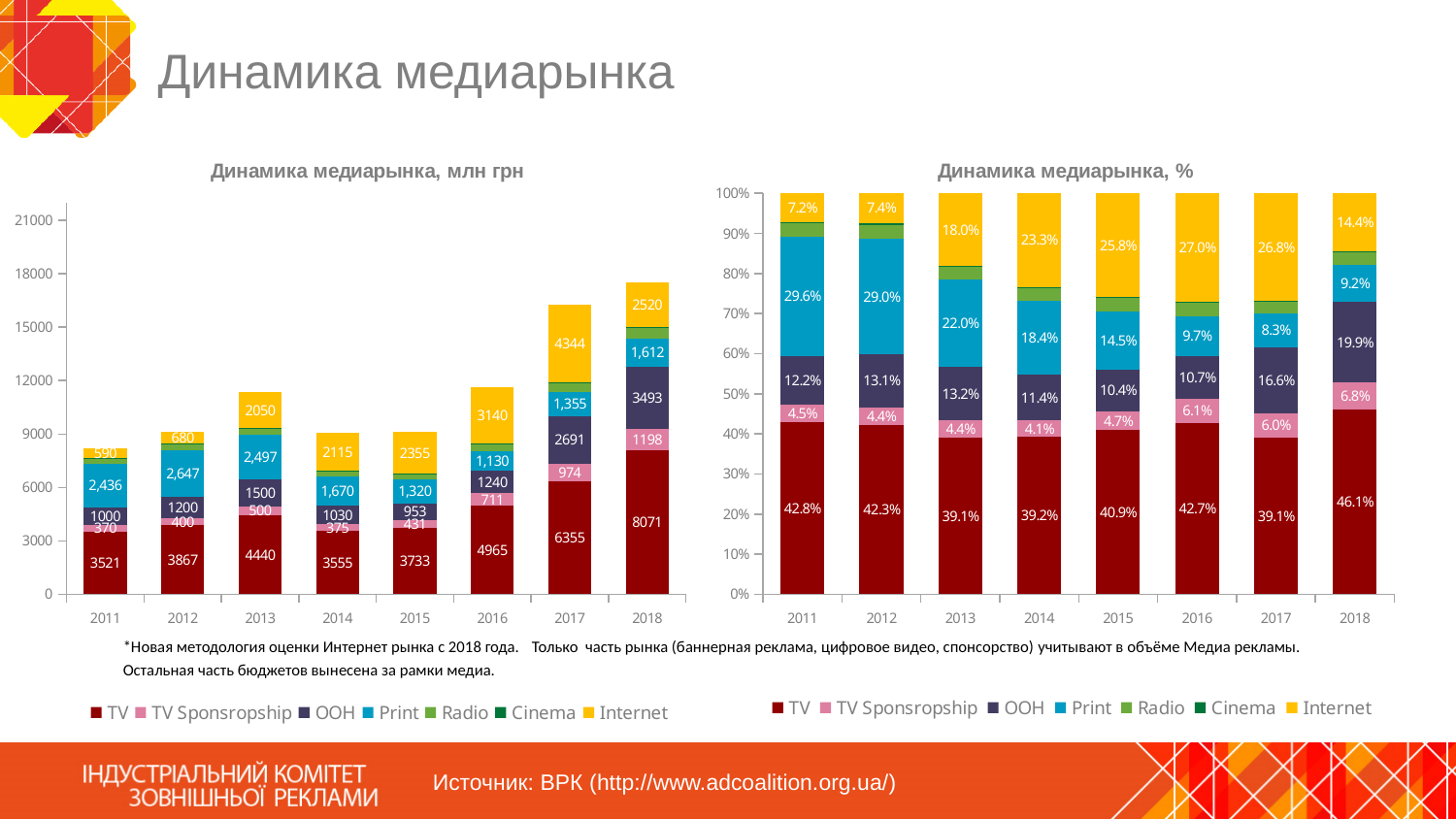
In the chart 'Динамика медиарынка, %', which is larger in 2018: the OOH share or the Print share? OOH In the chart 'Динамика медиарынка, %', what is the Print share for 2011? 29.6% In the chart 'Динамика медиарынка, млн грн', what is the Internet value for 2017? 4344 In the chart 'Динамика медиарынка, %', which year has the lowest Internet share? 2011 In the chart 'Динамика медиарынка, млн грн', does the Internet value rise or fall from 2011 to 2017? Rises In the chart 'Динамика медиарынка, млн грн', by how much did the TV value increase from 2017 to 2018? 1716 What kind of chart is 'Динамика медиарынка, млн грн'? Stacked bar chart In the chart 'Динамика медиарынка, млн грн', which year has the highest TV value? 2018 How many series does the legend of the chart 'Динамика медиарынка, %' list? 7 In the chart 'Динамика медиарынка, млн грн', is the total height of the 2018 bar greater or less than 15000? greater How many years are shown on the x axis of the chart 'Динамика медиарынка, млн грн'? 8 In the chart 'Динамика медиарынка, млн грн', what is the TV value for 2018? 8071